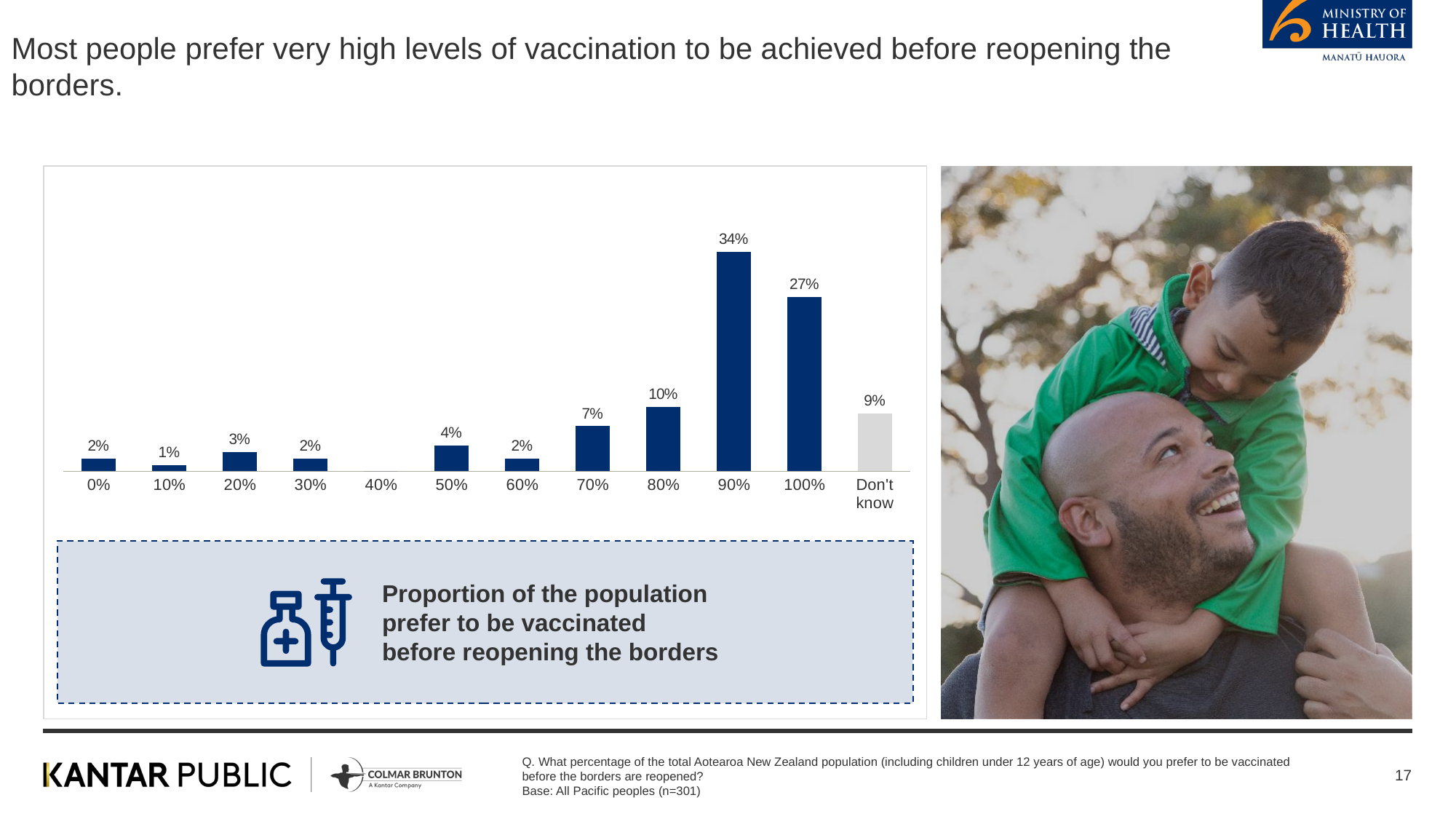
How many categories are shown on the x axis of the chart? 12 Which category has the highest value? 90% What is the value shown for the 50% category? 4% What kind of chart is shown on the slide? Bar chart Which has a larger value, the 70% category or the 80% category? 80% What percentage of respondents answered 'Don't know'? 9% What percentage of respondents prefer 90% of the population to be vaccinated before reopening the borders? 34% Which bar in the chart is coloured grey rather than dark blue? Don't know What is the value shown for the 80% category? 10% What percentage of respondents prefer 100% of the population to be vaccinated before reopening the borders? 27% What is the combined value of the 90% and 100% categories? 61% What is the difference between the values for the 90% and 100% categories? 7 percentage points